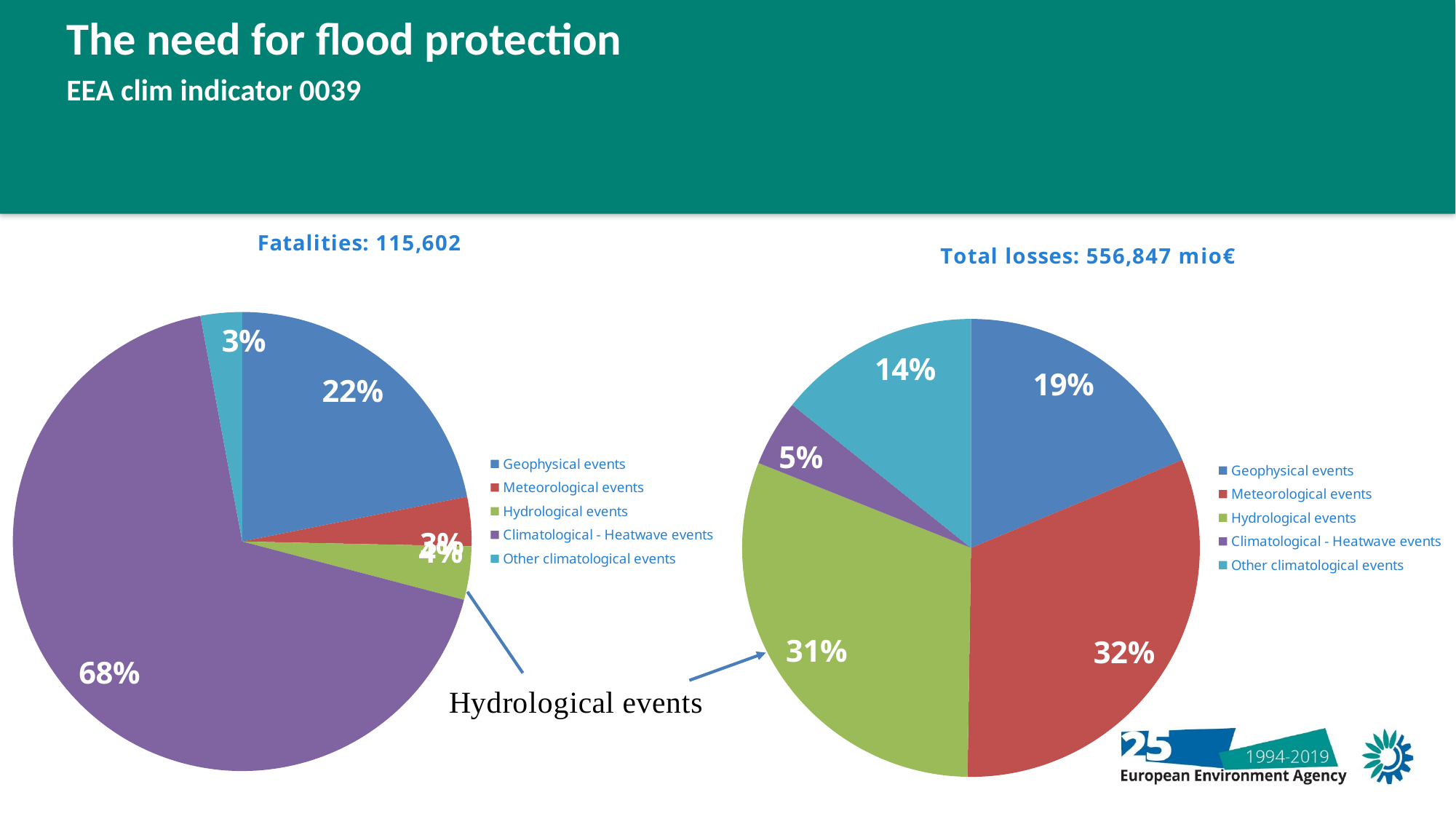
How many categories does the legend of the Total losses pie chart list? 5 In the Fatalities pie chart, what share is labelled for Geophysical events? 22% In the Total losses pie chart, what is the difference in percentage points between Geophysical events and Climatological - Heatwave events? 14 In the Total losses pie chart, what share is labelled for Meteorological events? 32% What type of chart is used for Total losses? Pie chart In the Total losses pie chart, which category has the smallest slice? Climatological - Heatwave events In the Fatalities pie chart, which is larger: Geophysical events or Other climatological events? Geophysical events In the Total losses pie chart, what share is labelled for Hydrological events? 31% In the Fatalities pie chart, which category has the largest slice? Climatological - Heatwave events In the Fatalities pie chart, what share is labelled for Other climatological events? 3% In the Total losses pie chart, what share is labelled for Other climatological events? 14% In the Fatalities pie chart, what share is labelled for Climatological - Heatwave events? 68%